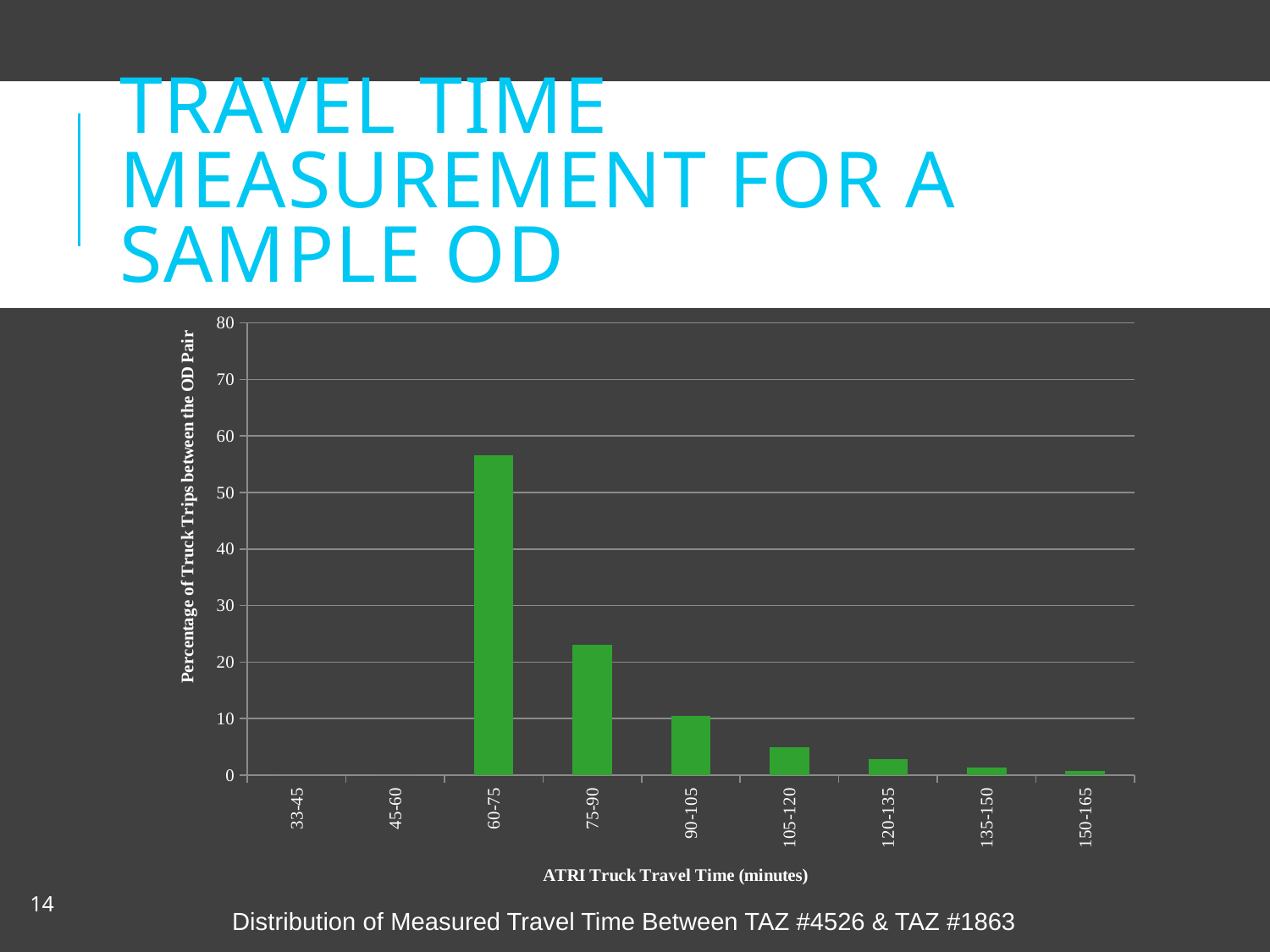
What is the title of the x axis? ATRI Truck Travel Time (minutes) How many travel time categories are shown on the x axis? 9 What kind of chart is shown on the slide? bar chart Which travel time category has the highest percentage of truck trips? 60-75 Is the value for 75-90 greater or less than 30? less Is the value for 75-90 greater or less than 20? greater What is the title of the y axis? Percentage of Truck Trips between the OD Pair Is the value for 60-75 greater or less than 50? greater Do the values rise or fall across the categories from 60-75 to 150-165? fall Which has a larger percentage of truck trips, 60-75 or 75-90? 60-75 Which has a larger percentage of truck trips, 90-105 or 105-120? 90-105